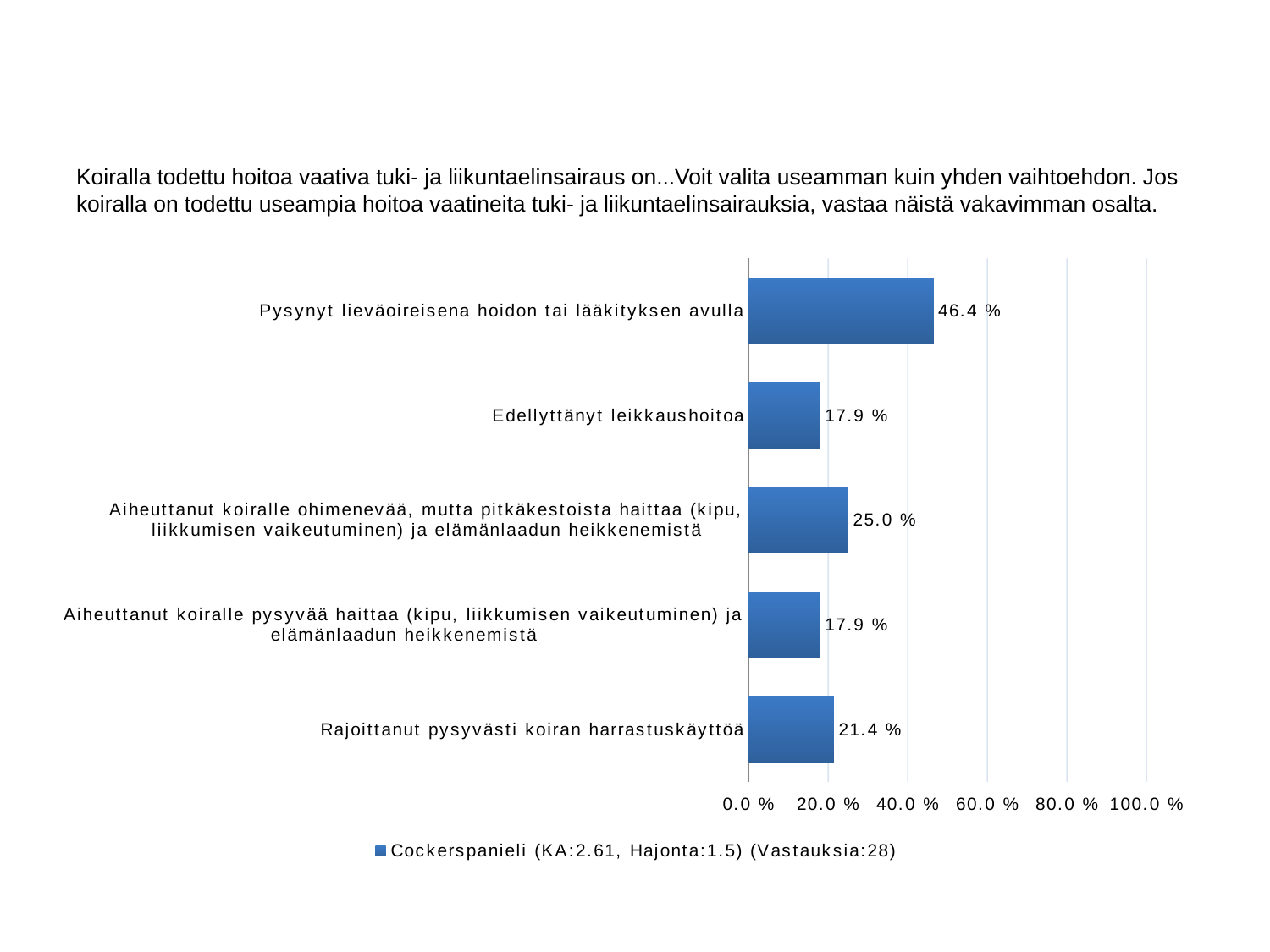
How many categories are shown in the chart? 5 What kind of chart is shown on the slide? bar chart What is the value for "Rajoittanut pysyvästi koiran harrastuskäyttöä"? 21.4 % How many responses (Vastauksia) does the legend entry report? 28 What is the value for "Edellyttänyt leikkaushoitoa"? 17.9 % How many series does the legend list? 1 Is the value for "Pysynyt lieväoireisena hoidon tai lääkityksen avulla" greater or less than 40.0 %? greater What is the value for "Pysynyt lieväoireisena hoidon tai lääkityksen avulla"? 46.4 % Which category has the highest value? Pysynyt lieväoireisena hoidon tai lääkityksen avulla What is the value for "Aiheuttanut koiralle ohimenevää, mutta pitkäkestoista haittaa (kipu, liikkumisen vaikeutuminen) ja elämänlaadun heikkenemistä"? 25.0 % Which is larger: the value for "Rajoittanut pysyvästi koiran harrastuskäyttöä" or the value for "Edellyttänyt leikkaushoitoa"? Rajoittanut pysyvästi koiran harrastuskäyttöä What is the difference between the values for "Pysynyt lieväoireisena hoidon tai lääkityksen avulla" and "Rajoittanut pysyvästi koiran harrastuskäyttöä"? 25.0 %